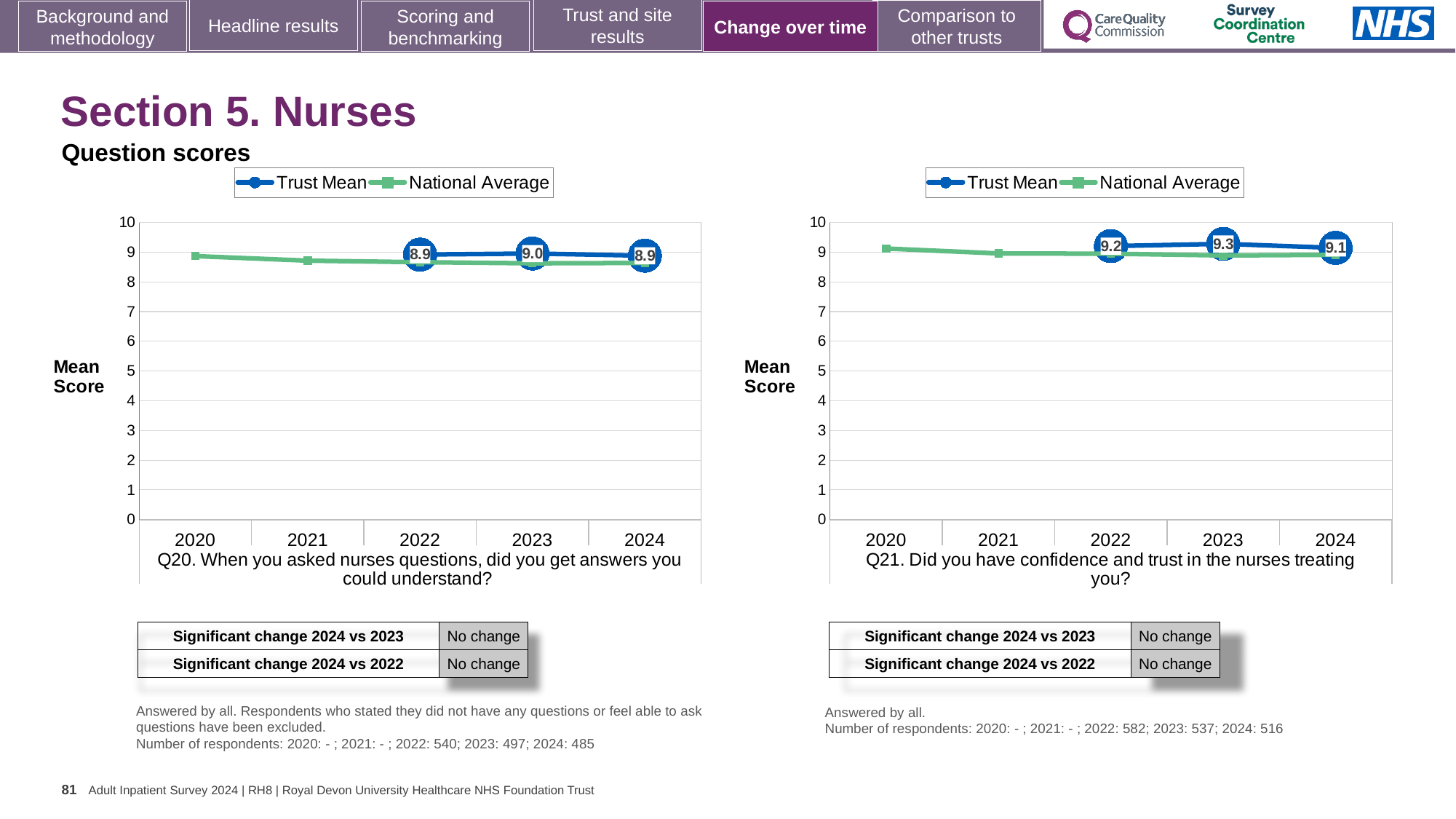
In the Q20 chart (left), is the Trust Mean score for 2023 greater or less than the Trust Mean score for 2024? greater In the Q21 chart (right), what is the difference between the Trust Mean scores for 2023 and 2024? 0.2 In the Q20 chart (left), what is the Trust Mean score for 2023? 9.0 In the Q20 chart (left), is the National Average for 2020 greater or less than 8? greater How many series does the legend of the Q20 chart (left) list? 2 In the Q21 chart (right), which year has the lowest labelled Trust Mean score? 2024 How many years are shown on the x axis of the Q21 chart (right)? 5 What type of chart is used for Q20 (left)? Line chart In the Q20 chart (left), what is the Trust Mean score for 2024? 8.9 In the Q21 chart (right), what is the Trust Mean score for 2022? 9.2 In the Q21 chart (right), what is the Trust Mean score for 2024? 9.1 In the Q21 chart (right), which year has the highest Trust Mean score? 2023